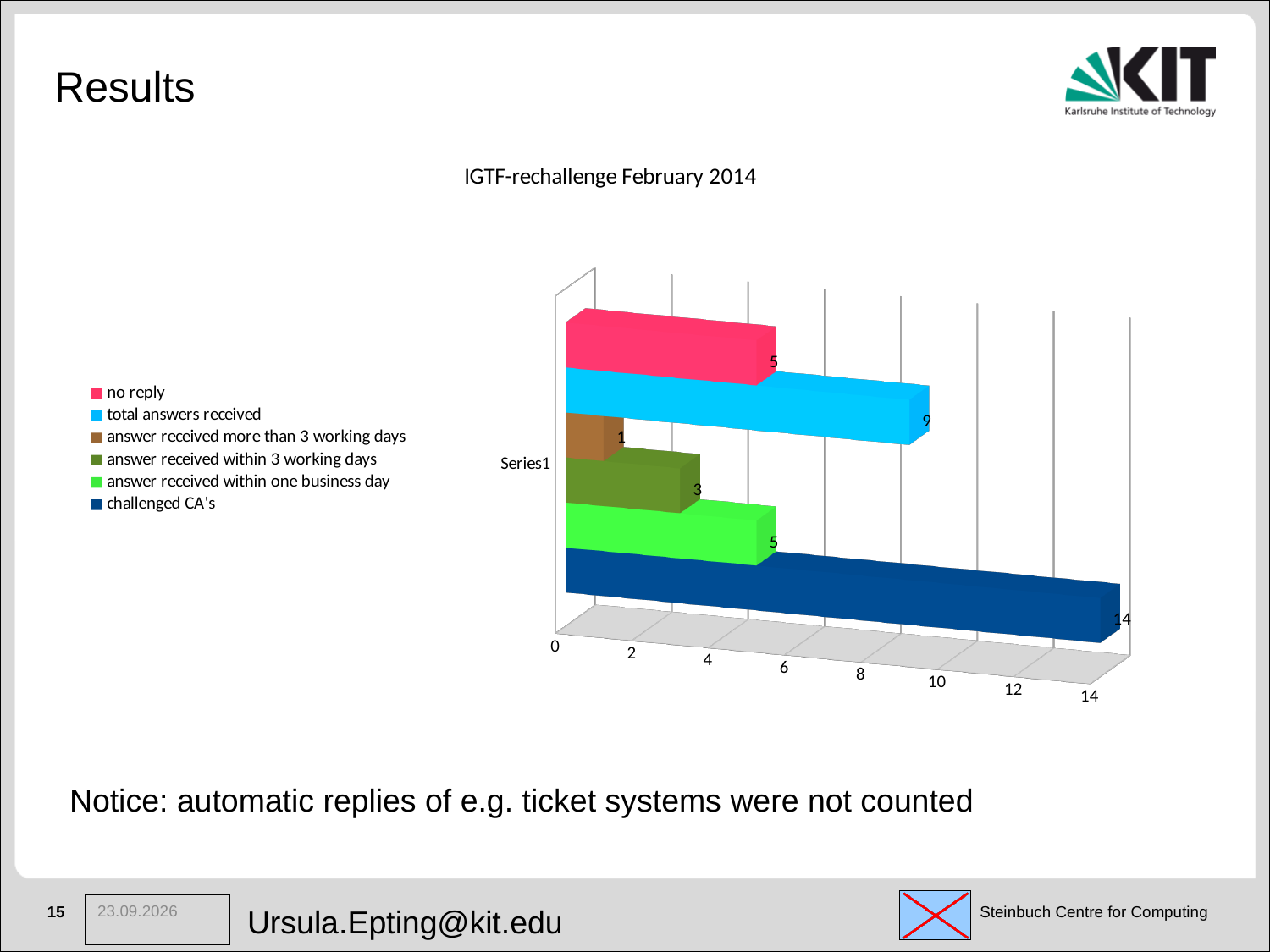
Which series has the highest value? challenged CA's What is the value for 'answer received within 3 working days'? 3 Which series has the lowest value? answer received more than 3 working days What is the value for 'answer received more than 3 working days'? 1 How many series does the chart legend list? 6 What is the value for 'challenged CA's'? 14 What is the value for 'total answers received'? 9 What is the value for 'no reply'? 5 What is the title of the chart? IGTF-rechallenge February 2014 What type of chart is shown on the slide? bar chart What is the difference between the value for 'challenged CA's' and the value for 'total answers received'? 5 Which is larger, the value for 'total answers received' or the value for 'no reply'? total answers received